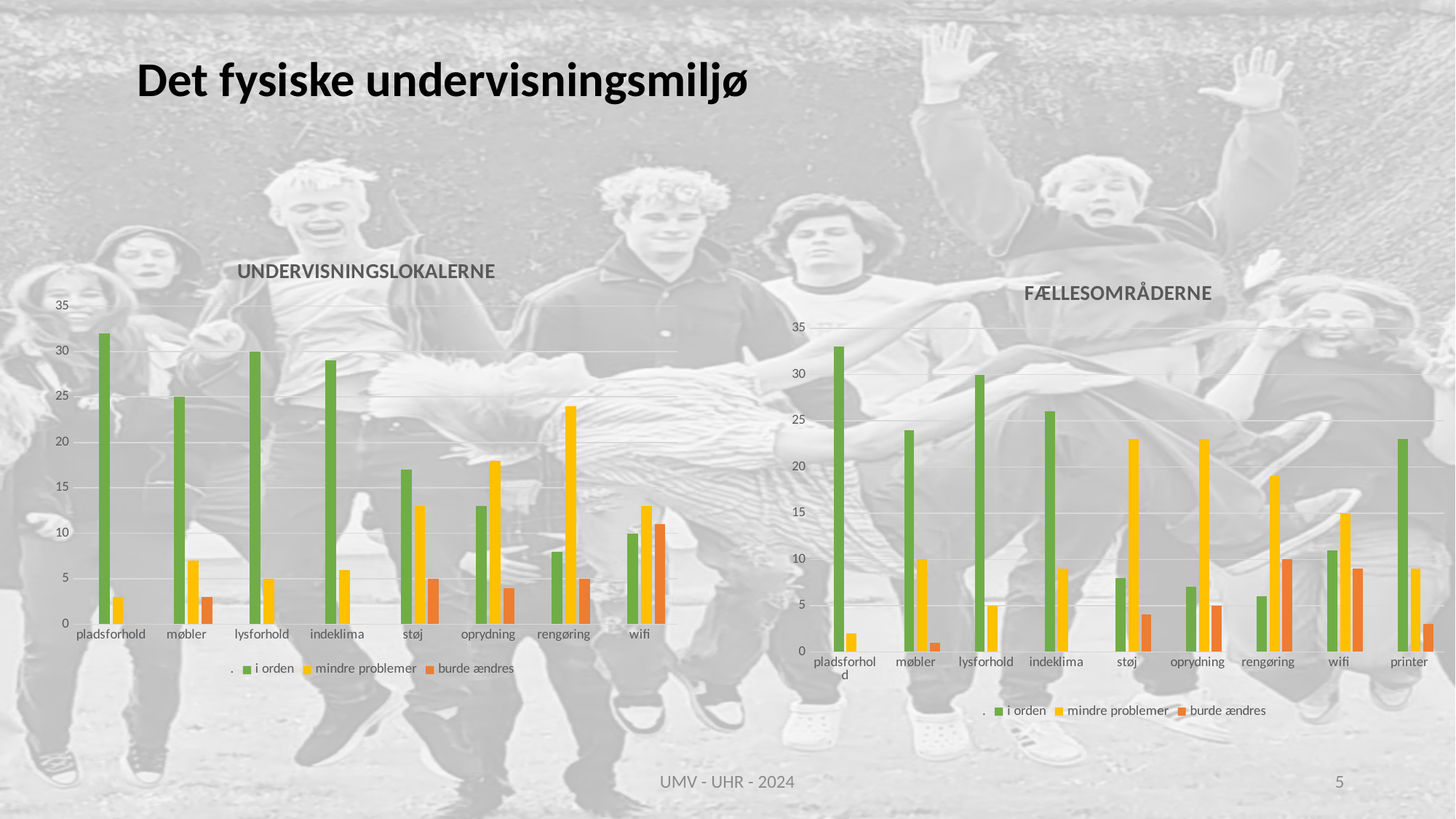
In the UNDERVISNINGSLOKALERNE chart, which category has the lowest 'i orden' value? rengøring Which series is shown in orange in the legend of the UNDERVISNINGSLOKALERNE chart? burde ændres In the FÆLLESOMRÅDERNE chart, is the 'i orden' value for printer greater or less than 25? less In the UNDERVISNINGSLOKALERNE chart, is the 'i orden' value for indeklima greater or less than 25? greater How many categories are shown on the x axis of the UNDERVISNINGSLOKALERNE chart? 8 In the UNDERVISNINGSLOKALERNE chart, which is larger: the 'mindre problemer' value for rengøring or for oprydning? rengøring How many categories are shown on the x axis of the FÆLLESOMRÅDERNE chart? 9 What kind of chart is the UNDERVISNINGSLOKALERNE chart? bar chart In the FÆLLESOMRÅDERNE chart, which category has the highest 'i orden' value? pladsforhold In the FÆLLESOMRÅDERNE chart, is the 'mindre problemer' value for støj greater or less than 20? greater In the UNDERVISNINGSLOKALERNE chart, which category has the highest 'i orden' value? pladsforhold